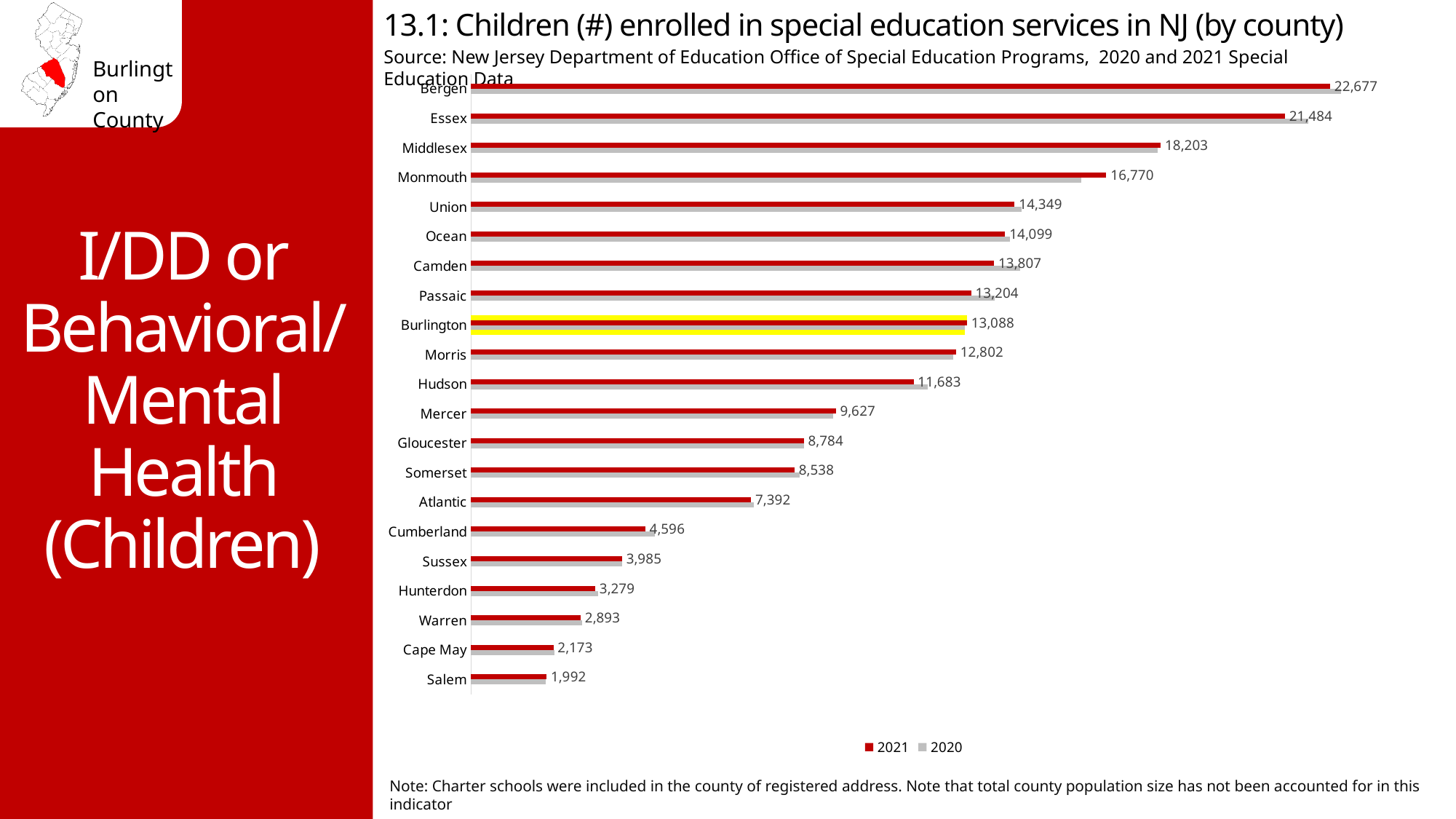
What is the 2021 value for Salem? 1,992 Which county has the highest number of children enrolled in special education services in 2021? Bergen How many counties are shown in the chart? 21 What is the difference between the 2021 values for Burlington and Morris? 286 What is the 2021 value for Burlington? 13,088 What is the 2021 value for Bergen? 22,677 Which county's bars are highlighted in yellow? Burlington How many series does the legend list? 2 What is the difference between the 2021 values for Bergen and Essex? 1,193 What kind of chart is shown on the slide? Bar chart Which county has a larger 2021 value, Camden or Passaic? Camden Which county has the lowest number of children enrolled in special education services in 2021? Salem